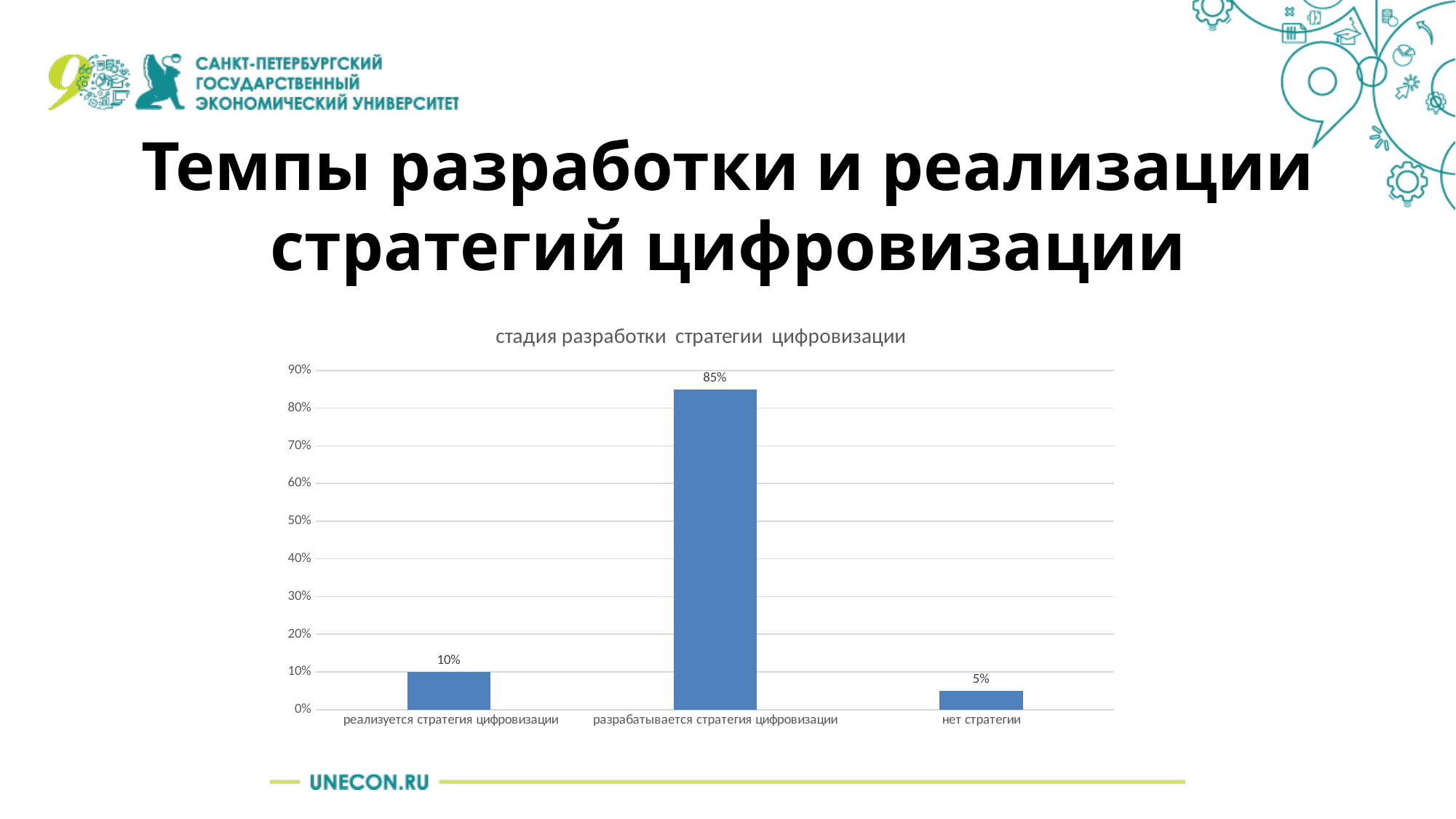
Is the value for "разрабатывается стратегия цифровизации" greater or less than 80%? greater What is the difference between the values for "разрабатывается стратегия цифровизации" and "реализуется стратегия цифровизации"? 75% What kind of chart is shown on the slide? bar chart Which category has the highest value? разрабатывается стратегия цифровизации What is the value for "разрабатывается стратегия цифровизации"? 85% What is the value for "нет стратегии"? 5% Which is larger: the value for "реализуется стратегия цифровизации" or the value for "нет стратегии"? реализуется стратегия цифровизации What is the value for "реализуется стратегия цифровизации"? 10% What is the title of the chart? стадия разработки стратегии цифровизации How many categories are shown on the chart? 3 What is the difference between the values for "реализуется стратегия цифровизации" and "нет стратегии"? 5% Which category has the lowest value? нет стратегии